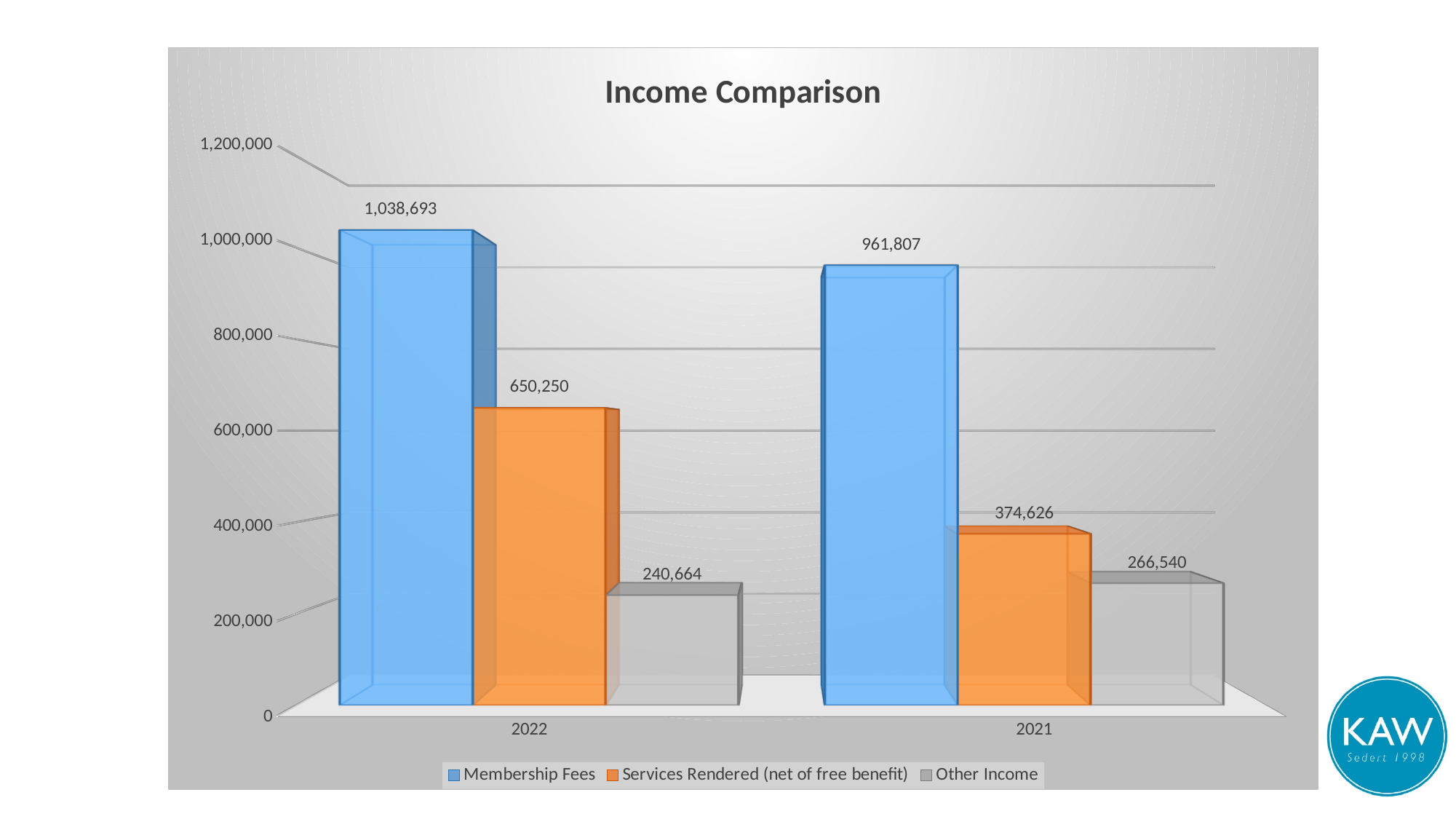
What is the difference between Services Rendered (net of free benefit) in 2022 and 2021? 275,624 Which series has the highest value in 2021? Membership Fees What is the difference between Membership Fees in 2022 and 2021? 76,886 Is the value for Services Rendered (net of free benefit) in 2022 greater or less than 600,000? greater What is the title of the chart? Income Comparison What is the value of Other Income for 2022? 240,664 What is the value of Membership Fees for 2022? 1,038,693 What kind of chart is shown? bar chart How many series does the legend list? 3 Which series has the lowest value in 2022? Other Income What is the value of Services Rendered (net of free benefit) for 2021? 374,626 Which is larger: Other Income in 2022 or Other Income in 2021? Other Income in 2021